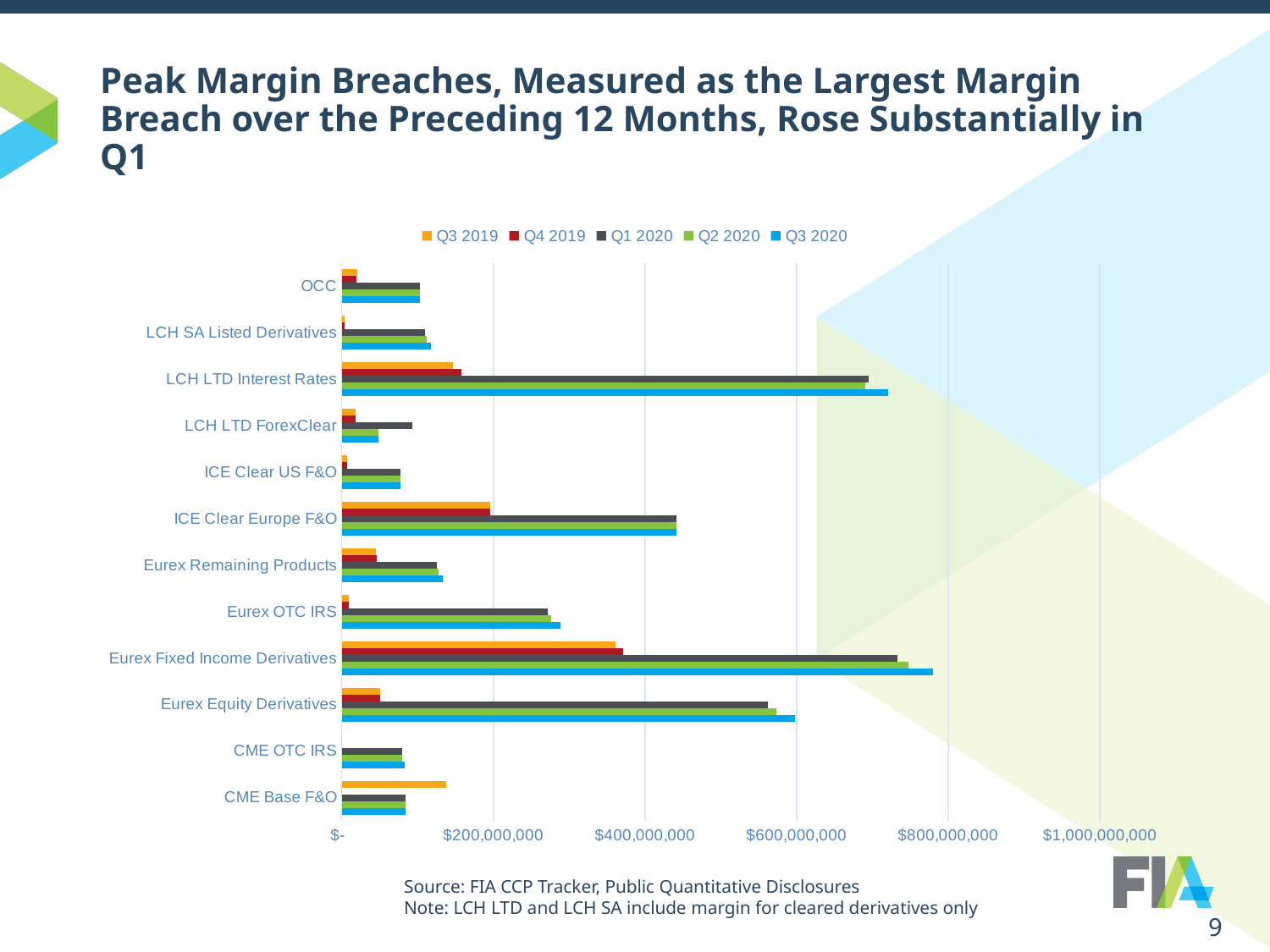
Which series is listed first in the legend? Q3 2019 How many clearing services (categories) are shown on the y axis? 12 Which is larger: the Q3 2019 value for Eurex Fixed Income Derivatives or the Q3 2019 value for Eurex Equity Derivatives? Eurex Fixed Income Derivatives Is the Q3 2020 value for OCC greater or less than $200,000,000? less Which category has the highest Q3 2020 value? Eurex Fixed Income Derivatives Is the Q3 2020 value for Eurex Fixed Income Derivatives greater or less than $600,000,000? greater Is the Q3 2020 value for ICE Clear Europe F&O greater or less than $600,000,000? less What kind of chart is shown on the slide? bar chart How many series does the legend list? 5 Which category has the highest Q3 2019 value? Eurex Fixed Income Derivatives Which is larger: the Q1 2020 value for ICE Clear Europe F&O or the Q1 2020 value for Eurex OTC IRS? ICE Clear Europe F&O